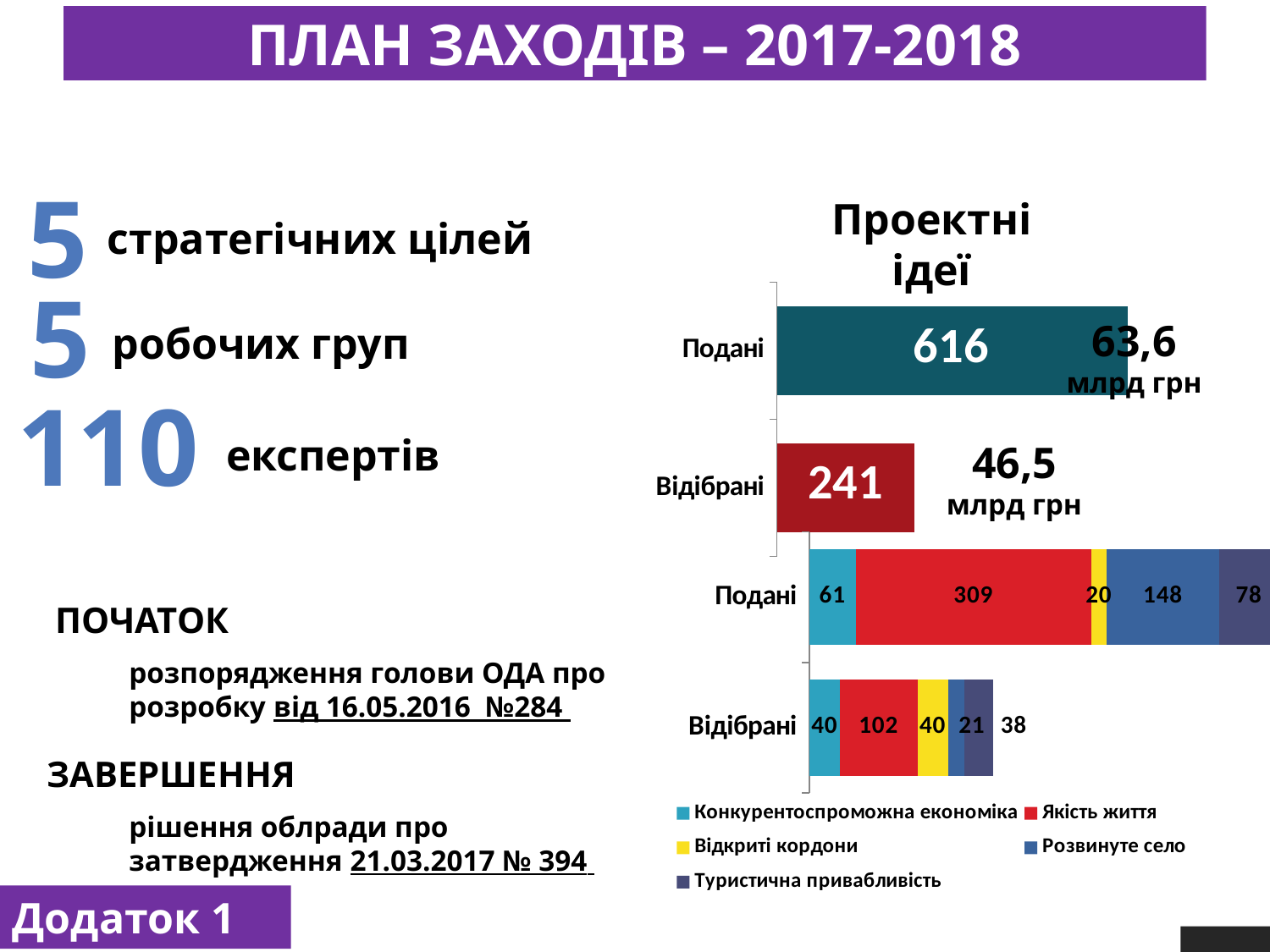
In the top chart titled 'Проектні ідеї', what amount in млрд грн is shown next to the 'Відібрані' bar? 46,5 млрд грн In the bottom stacked bar chart, what is the total of the 'Відібрані' bar? 241 In the bottom stacked bar chart, what is the value of 'Розвинуте село' for 'Відібрані'? 21 In the bottom stacked bar chart, what is the value of 'Якість життя' for 'Подані'? 309 In the top chart titled 'Проектні ідеї', what is the value for 'Відібрані'? 241 In the top chart titled 'Проектні ідеї', what is the difference between the 'Подані' and 'Відібрані' values? 375 In the bottom stacked bar chart, how many series does the legend list? 5 What kind of chart is the bottom chart on the slide? Stacked bar chart In the bottom stacked bar chart, what is the value of 'Туристична привабливість' for 'Подані'? 78 In the top chart titled 'Проектні ідеї', what is the value for 'Подані'? 616 In the bottom stacked bar chart, which series has the largest value in the 'Подані' bar? Якість життя In the bottom stacked bar chart, which series has the smallest value in the 'Відібрані' bar? Розвинуте село